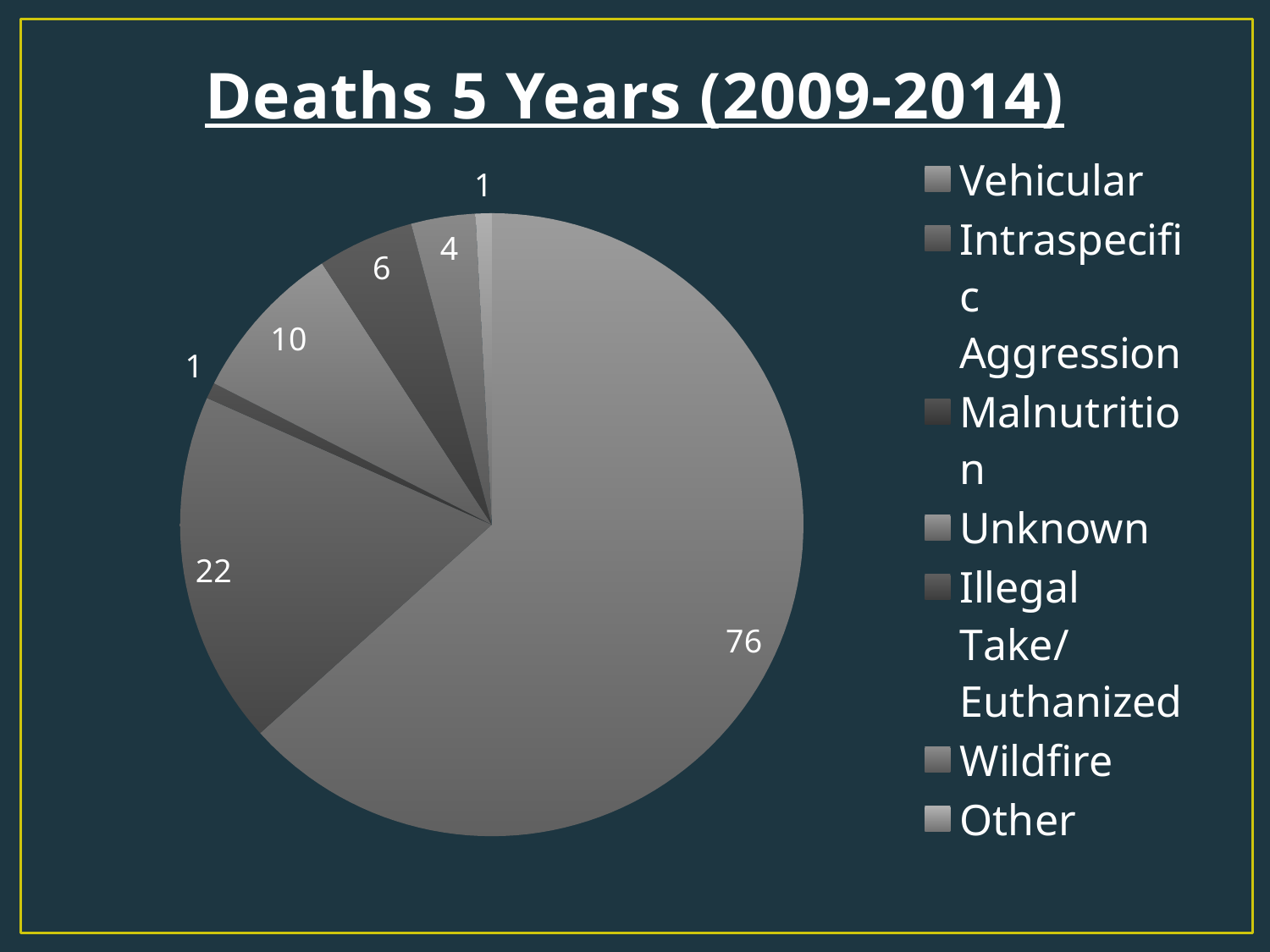
What is the value of the largest slice in the pie chart? 76 What is the smallest value labelled on the pie chart? 1 What is the value shown for Intraspecific Aggression? 22 How many categories does the legend list? 7 What type of chart is shown on the slide? pie chart What is the value shown for Unknown? 10 Which is larger, the slice for Unknown or the slice for Illegal Take/Euthanized? Unknown What is the value shown for Wildfire? 4 What is the total of all the values labelled on the pie chart? 120 What is the difference between the largest slice (76) and the second largest slice (22)? 54 What is the title of the chart? Deaths 5 Years (2009-2014) Which category has the largest slice in the pie chart? Vehicular